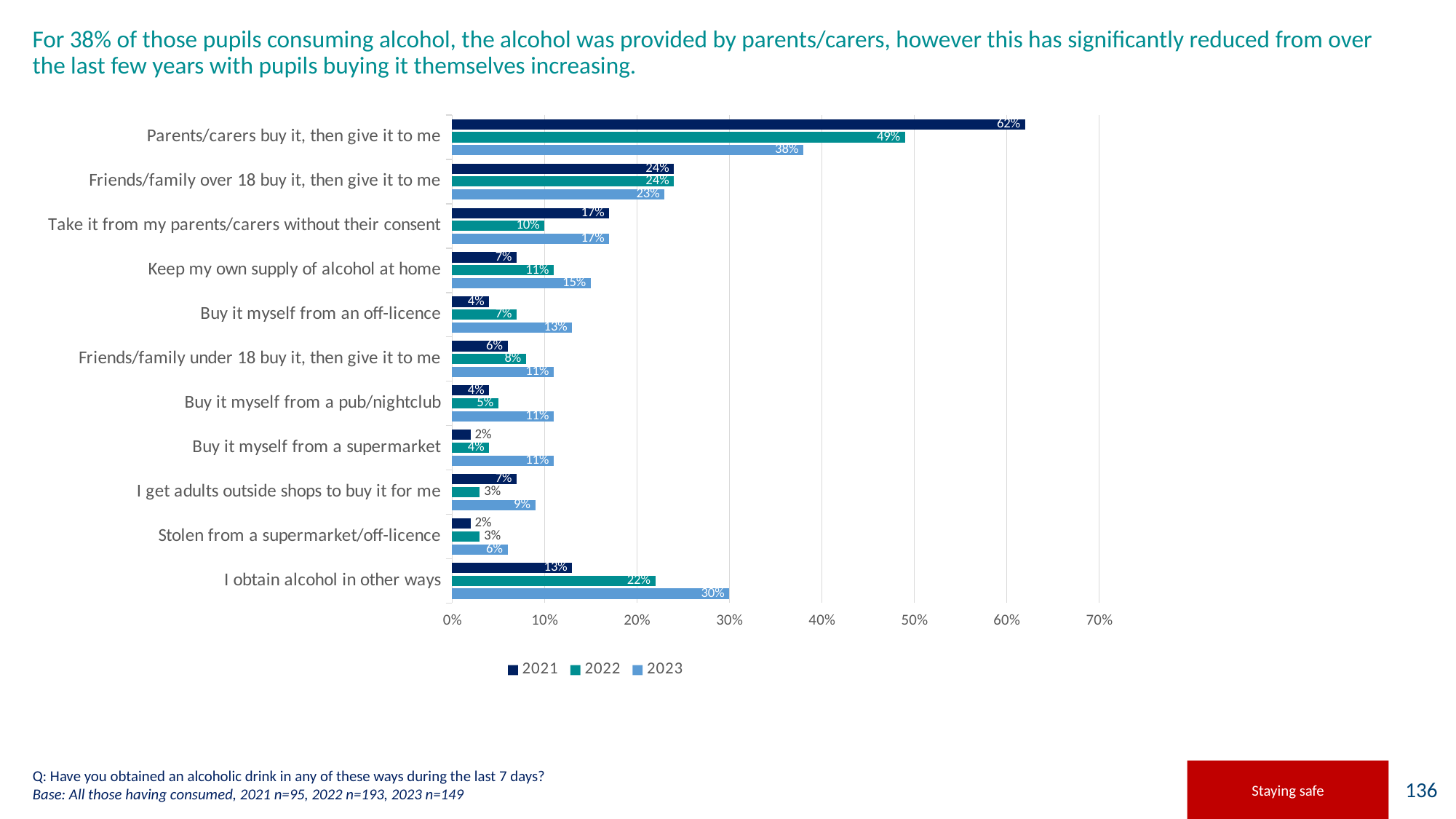
Which category has the highest 2023 value? Parents/carers buy it, then give it to me What is the 2023 value for "Parents/carers buy it, then give it to me"? 38% Which is larger for "Buy it myself from a supermarket": the 2022 value or the 2023 value? 2023 Which category has the lowest 2023 value? Stolen from a supermarket/off-licence What kind of chart is shown on the slide? Bar chart Which years are listed in the chart legend? 2021, 2022, 2023 What is the difference between the 2021 and 2023 values for "Parents/carers buy it, then give it to me"? 24 percentage points How many series does the legend list? 3 What is the 2021 value for "Parents/carers buy it, then give it to me"? 62% What is the 2022 value for "I obtain alcohol in other ways"? 22% What is the 2023 value for "Buy it myself from an off-licence"? 13% How many categories are shown on the chart? 11